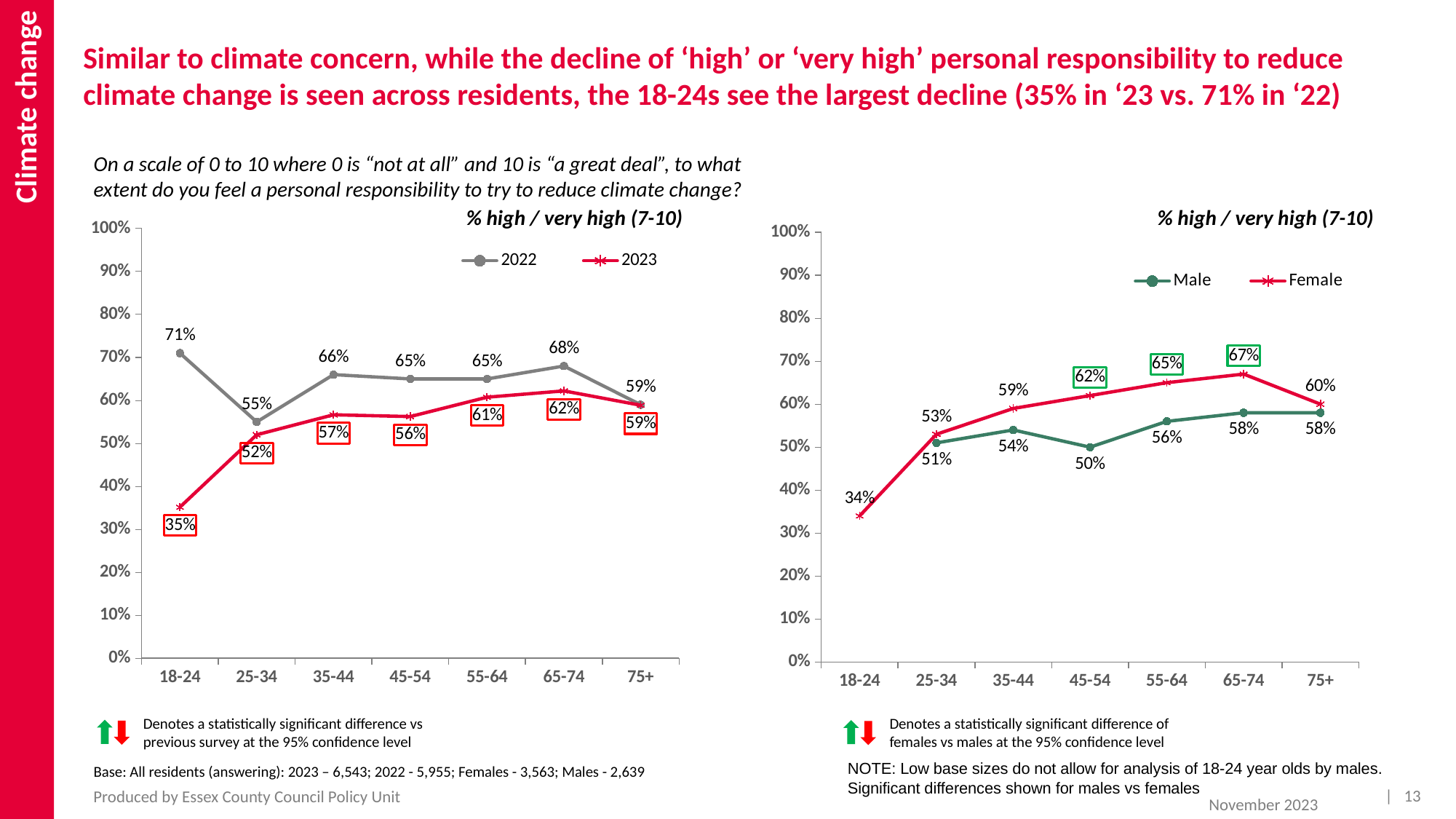
In the right chart (Male vs Female), which is larger for the 55-64 age group, the Male value or the Female value? Female What type of chart is the right chart (Male vs Female)? Line chart In the left chart (2022 vs 2023), what is the 2022 value for the 65-74 age group? 68% In the right chart (Male vs Female), what is the Male value for the 45-54 age group? 50% In the right chart (Male vs Female), what is the Female value for the 65-74 age group? 67% In the right chart (Male vs Female), what is the difference between the Female and Male values for the 45-54 age group? 12 percentage points In the left chart (2022 vs 2023), how many series does the legend list? 2 In the left chart (2022 vs 2023), what is the difference between the 2022 and 2023 values for the 18-24 age group? 36 percentage points In the left chart (2022 vs 2023), which age group has the lowest 2023 value? 18-24 In the left chart (2022 vs 2023), how many age groups are shown on the x axis? 7 In the left chart (2022 vs 2023), what is the 2023 value for the 18-24 age group? 35% In the left chart (2022 vs 2023), which age group has the highest 2022 value? 18-24